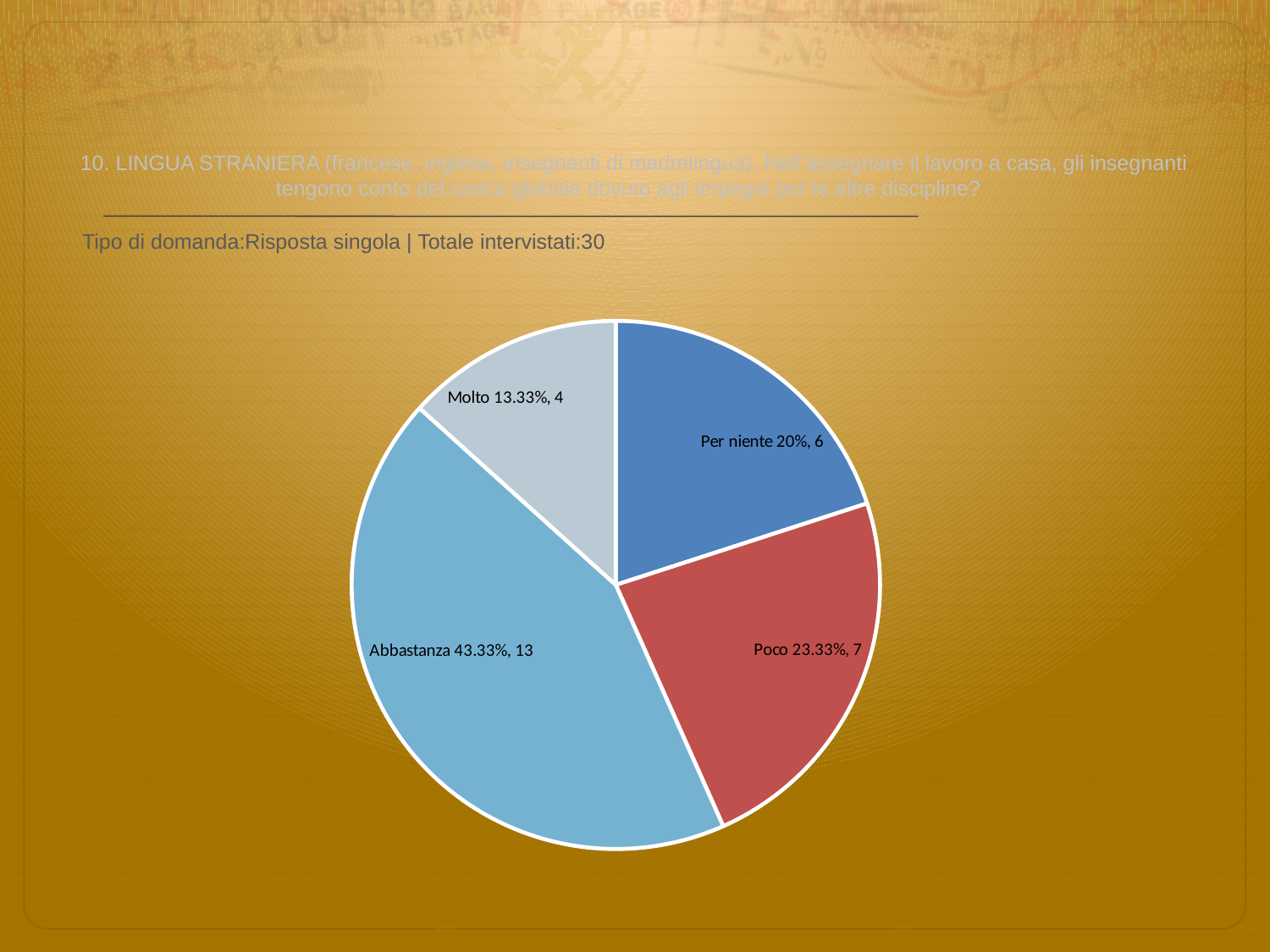
How many slices does the pie chart have? 4 What colour is the Poco slice? red How many respondents answered Poco? 7 What percentage share does the Per niente slice have? 20% How many respondents answered Molto? 4 What kind of chart is shown on the slide? pie chart Which response has the smallest slice of the pie? Molto Which response has the largest slice of the pie? Abbastanza What is the total number of respondents across all slices? 30 What percentage share does the Abbastanza slice have? 43.33% Which slice is larger, Per niente or Poco? Poco What is the difference in number of respondents between Abbastanza and Poco? 6